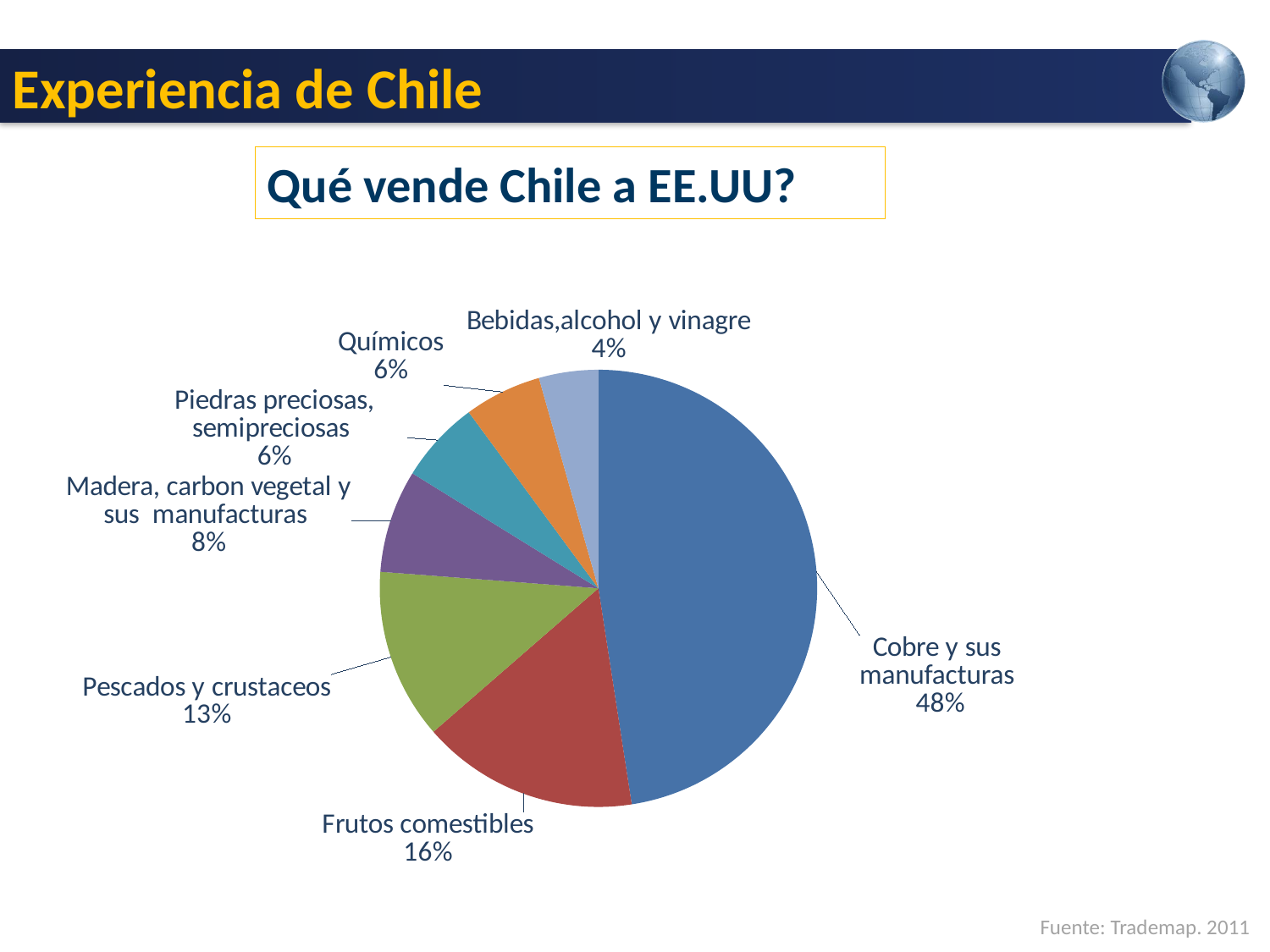
What is the value shown for Pescados y crustaceos? 13% Which is larger, the share for Madera, carbon vegetal y sus manufacturas or the share for Químicos? Madera, carbon vegetal y sus manufacturas What is the title of the chart? Qué vende Chile a EE.UU? What kind of chart is shown on the slide? pie chart How many categories are shown in the pie chart? 7 What share of the pie does Cobre y sus manufacturas represent? 48% What is the value shown for Frutos comestibles? 16% Which category has the smallest slice of the pie? Bebidas,alcohol y vinagre What is the value shown for Bebidas,alcohol y vinagre? 4% What is the value shown for Madera, carbon vegetal y sus manufacturas? 8% Which category has the largest slice of the pie? Cobre y sus manufacturas What is the difference between the shares of Frutos comestibles and Pescados y crustaceos? 3%